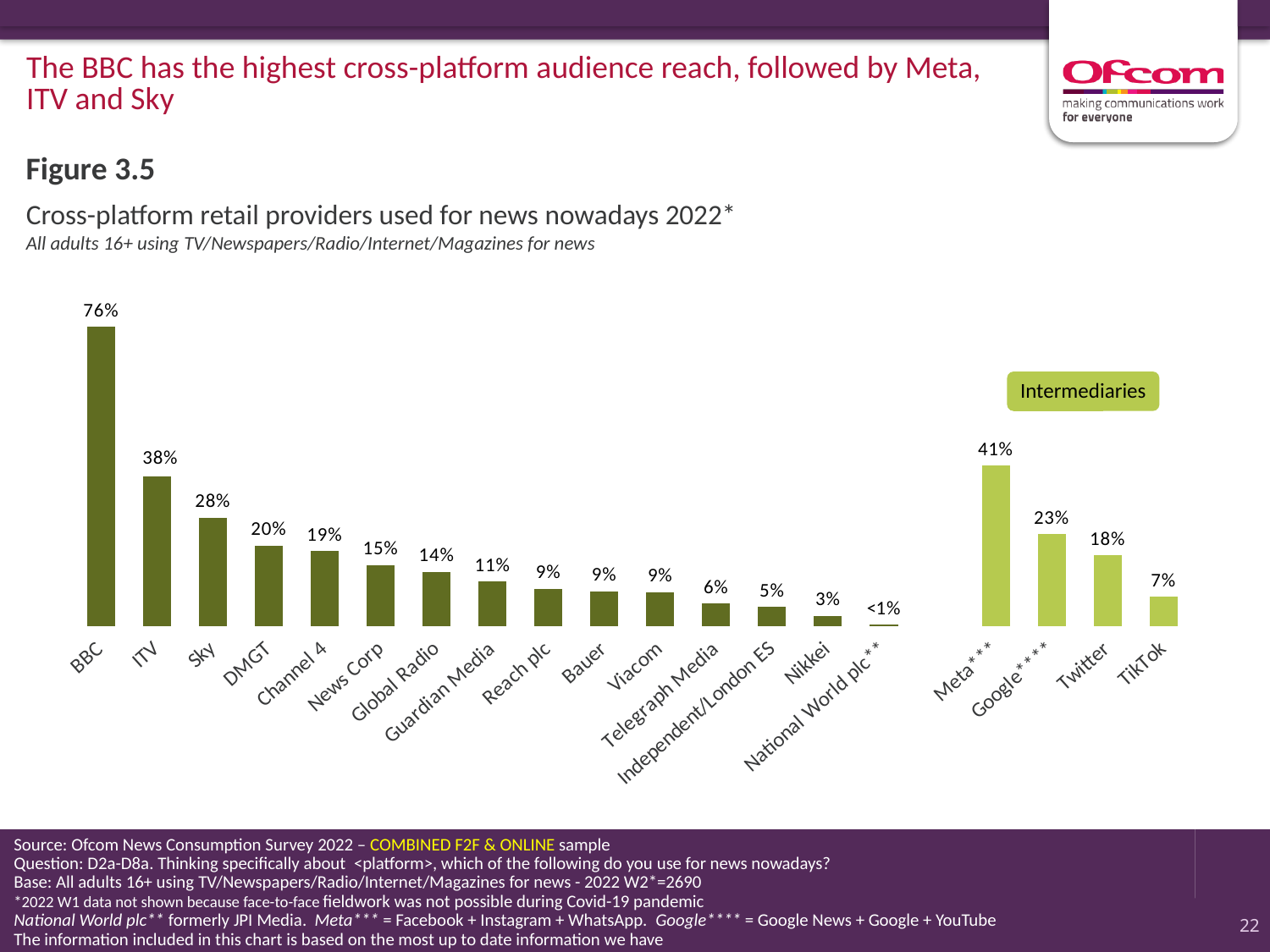
Which has a larger value, Google or DMGT? Google What is the value for BBC? 76% What is the difference between the values for ITV and Sky? 10% What is the value for TikTok? 7% What kind of chart is shown on the slide? Bar chart Which provider has the highest value on the chart? BBC What is the value for Meta? 41% What is the difference between the values for Meta and Twitter? 23% Which provider has the lowest value on the chart? National World plc How many providers are shown on the chart? 19 What label is shown in the box above the lighter green bars on the right of the chart? Intermediaries What is the value for Channel 4? 19%